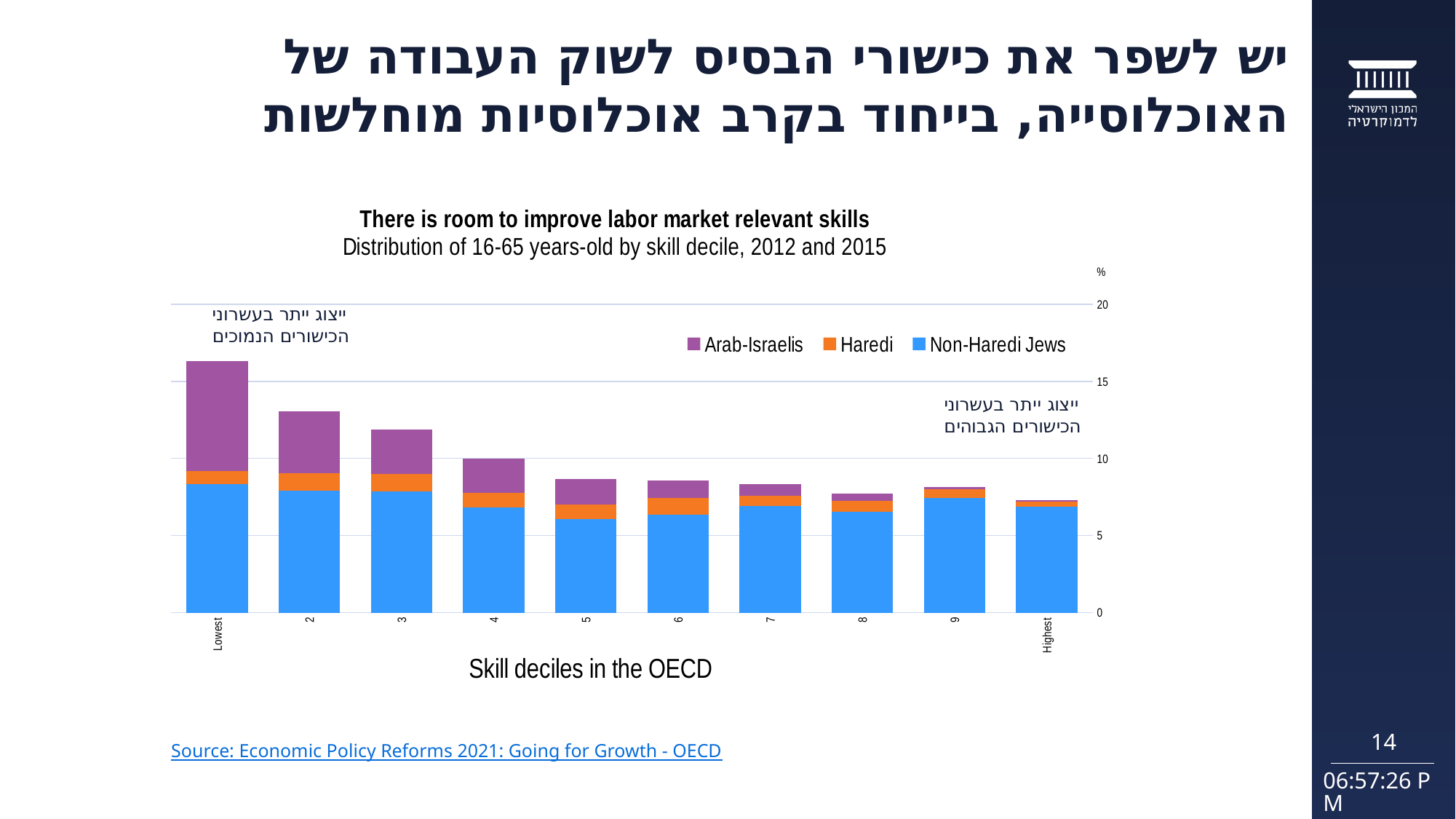
Do the total bar heights generally rise or fall from the Lowest decile to the Highest decile? fall Which skill decile has the highest total bar? Lowest Is the Non-Haredi Jews value for the Lowest skill decile greater or less than 5? greater How many series does the legend list? 3 What kind of chart is shown on the slide? Stacked bar chart What is the x-axis title of the chart? Skill deciles in the OECD Which series is shown in purple in the legend? Arab-Israelis How many skill deciles (categories) are shown on the x axis? 10 Is the total for the Lowest skill decile greater or less than 15? greater Which is larger, the total bar for the Lowest decile or the total bar for the Highest decile? Lowest Is the total for skill decile 2 greater or less than 15? less